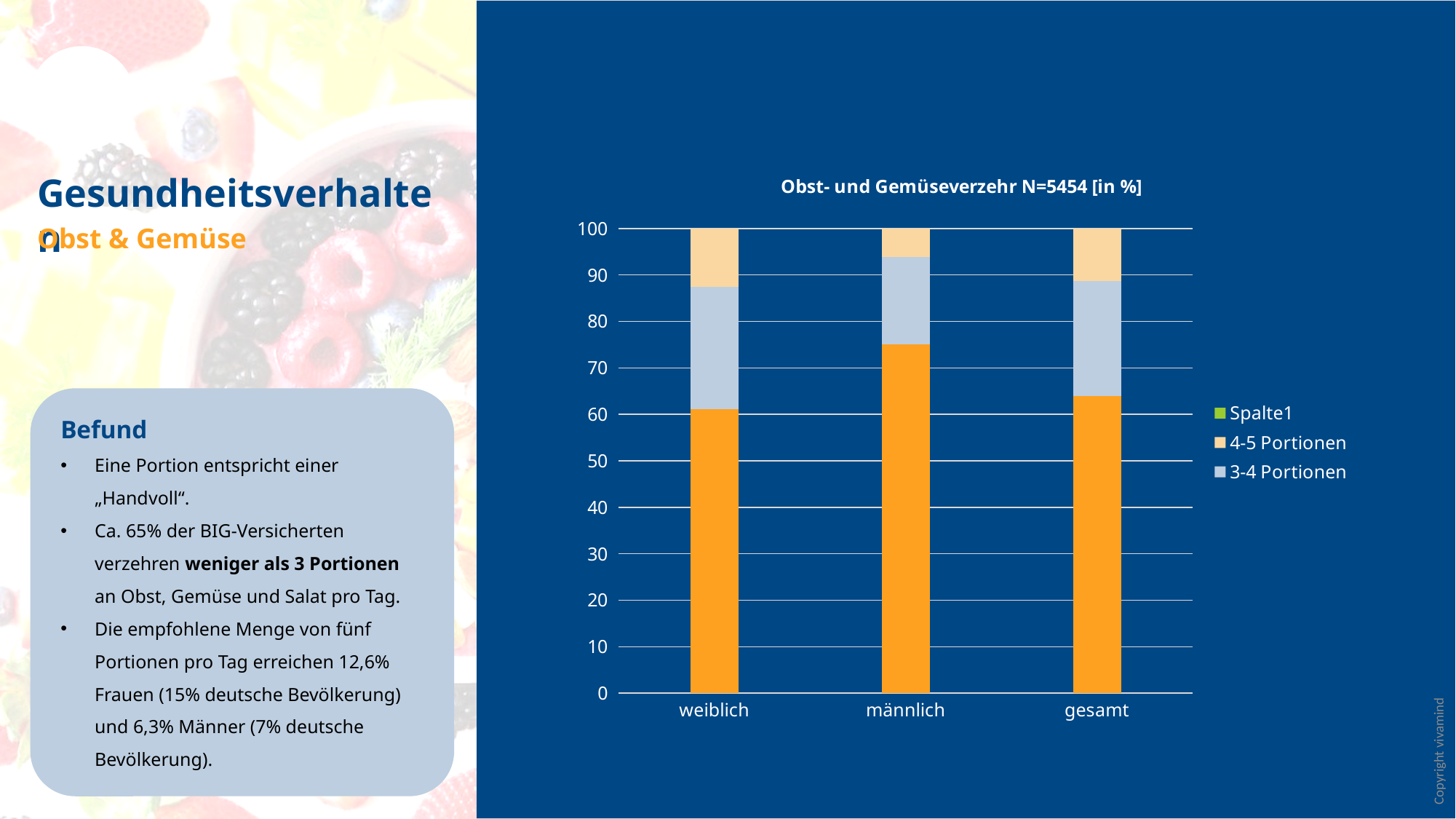
Is the '4-5 Portionen' segment larger for 'weiblich' or for 'männlich'? weiblich Is the top of the '3-4 Portionen' segment for 'männlich' greater or less than 90? greater What kind of chart is shown on the slide? Stacked bar chart How many series does the chart legend list? 3 What is the title of the chart? Obst- und Gemüseverzehr N=5454 [in %] What is the total height of the stacked bar for 'gesamt'? 100 Is the top of the orange (bottom) segment for 'weiblich' greater or less than 70? less How many categories are shown on the x axis of the chart? 3 Which category has the largest orange (bottom) segment? männlich Is the top of the orange (bottom) segment for 'gesamt' greater or less than 60? greater Which entries are listed in the chart legend? Spalte1, 4-5 Portionen, 3-4 Portionen